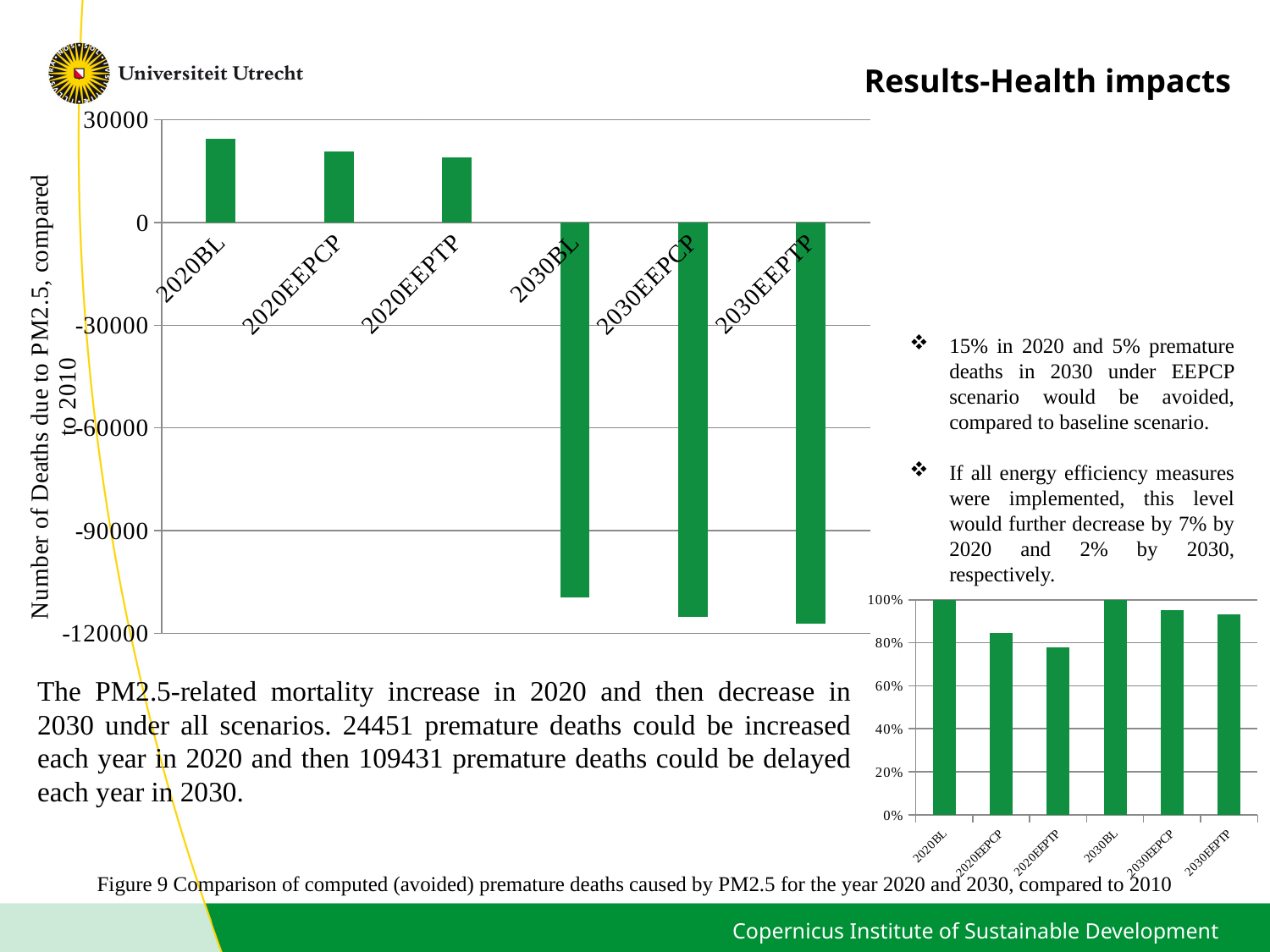
In the large chart on the left, which is larger, the value for 2020BL or the value for 2020EEPTP? 2020BL In the small chart at the bottom right, what is the value for 2030BL? 100% What is the y-axis title of the large chart on the left? Number of Deaths due to PM2.5, compared to 2010 In the small chart at the bottom right, which category has the lowest value? 2020EEPTP In the small chart at the bottom right, is the value for 2030EEPCP greater or less than 80%? greater In the large chart on the left, which category has the highest value? 2020BL In the small chart at the bottom right, what is the value for 2020BL? 100% How many categories are shown on the x axis of the large chart on the left? 6 In the large chart on the left, is the value for 2030BL greater or less than -90000? less In the large chart on the left, is the value for 2020EEPCP greater or less than 0? greater What kind of chart is the large chart on the left of the slide? bar chart In the large chart on the left, do the values generally rise or fall from left to right along the x axis? fall